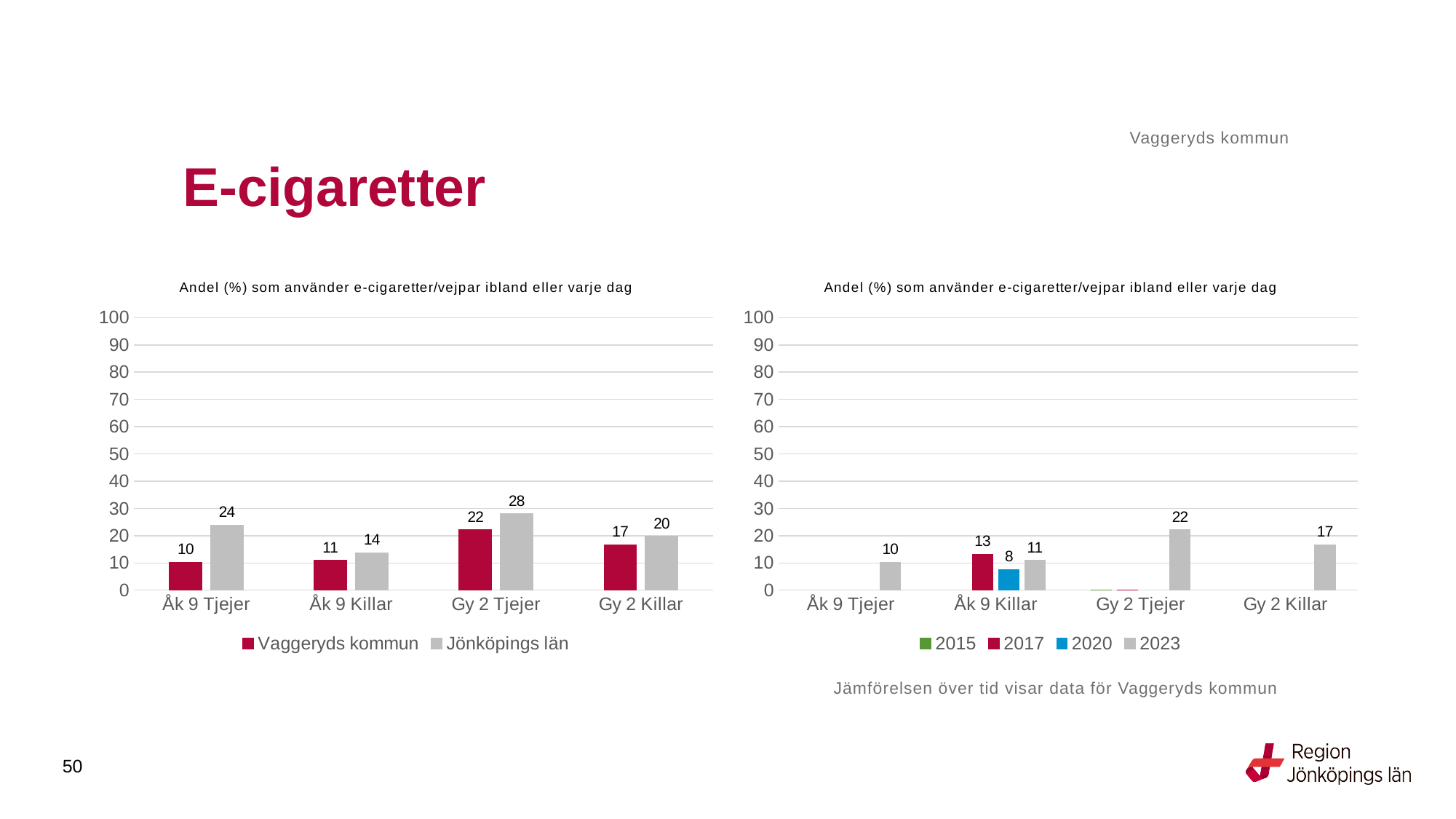
In the left chart, which category has the highest value for Vaggeryds kommun? Gy 2 Tjejer How many series does the legend of the right chart list? 4 In the left chart, what is the value for Vaggeryds kommun for Åk 9 Killar? 11 In the left chart, which category has the lowest value for Jönköpings län? Åk 9 Killar What kind of chart is the right chart? Bar chart In the left chart, which is larger for Gy 2 Killar: Vaggeryds kommun or Jönköpings län? Jönköpings län In the right chart, what is the difference between the 2017 and 2020 values for Åk 9 Killar? 5 In the left chart, what is the value for Jönköpings län for Gy 2 Tjejer? 28 In the right chart, what is the 2020 value for Åk 9 Killar? 8 How many series does the legend of the left chart list? 2 In the right chart, what is the 2023 value for Gy 2 Tjejer? 22 In the left chart, what is the difference between Jönköpings län and Vaggeryds kommun for Åk 9 Tjejer? 14